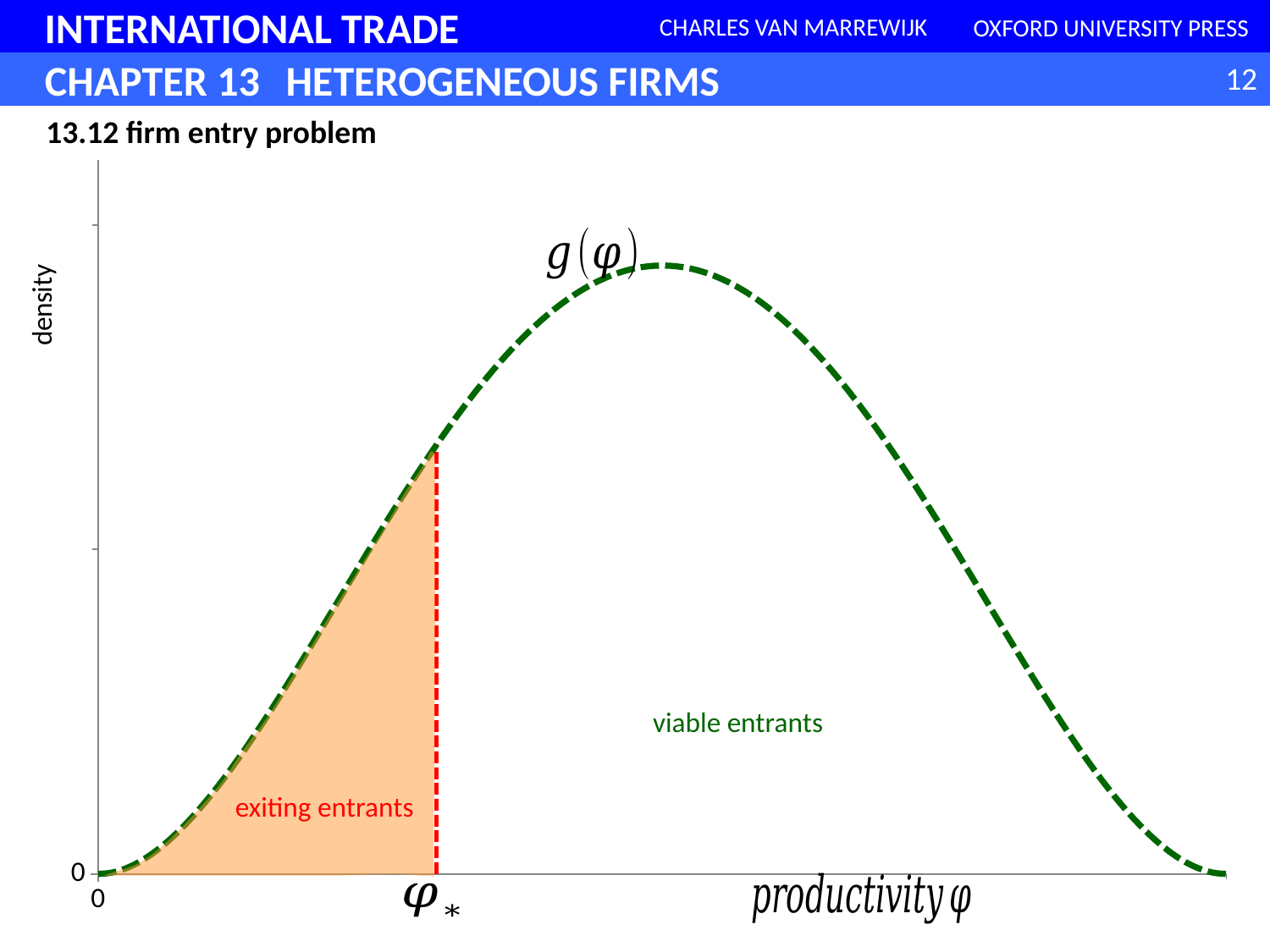
Is the density at the left end of the axis (productivity 0) greater or less than the density at φ*? less Is the density at the cutoff φ* greater or less than the peak density of g(φ)? less Is the value of g(φ) at the cutoff φ* greater or less than 0? greater Does the curve g(φ) rise or fall as productivity increases beyond its peak toward the right end of the axis? fall What label is on the horizontal axis of the chart? productivity φ What kind of chart is shown on the slide? line chart How many curves are plotted on the chart? 1 Does the curve g(φ) rise or fall as productivity increases from 0 to φ*? rise What is the title of the chart? 13.12 firm entry problem